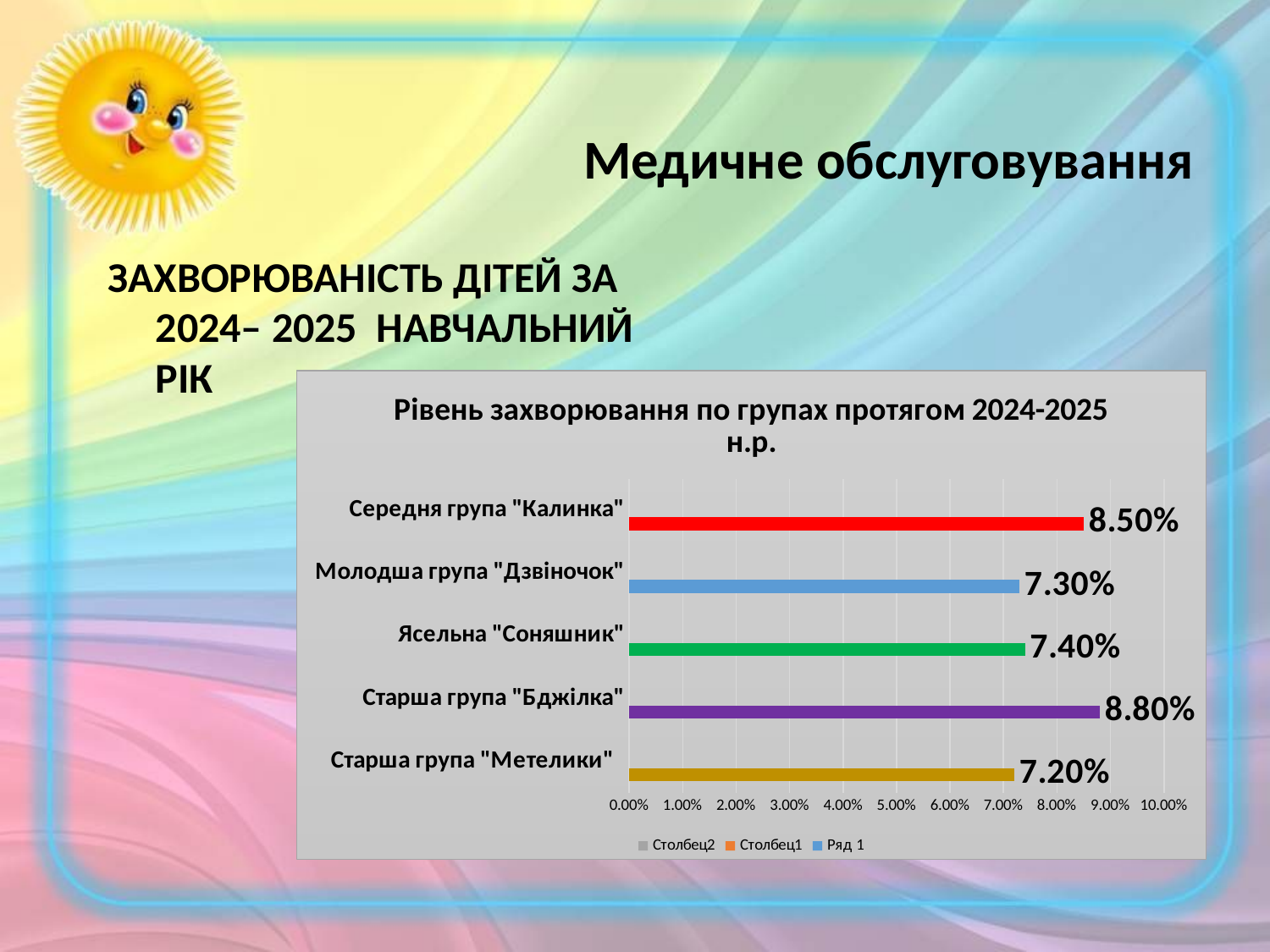
Which group has the highest value? Старша група "Бджілка" What is the difference between the values for Старша група "Бджілка" and Середня група "Калинка"? 0.30% What is the value for Ясельна "Соняшник"? 7.40% What kind of chart is shown on the slide? bar chart Which group has the lowest value? Старша група "Метелики" Is the value for Старша група "Бджілка" greater or less than 8.00%? greater How many groups are shown in the chart? 5 What is the value for Молодша група "Дзвіночок"? 7.30% Which is larger, the value for Середня група "Калинка" or the value for Ясельна "Соняшник"? Середня група "Калинка" What is the value for Старша група "Метелики"? 7.20% How many entries does the legend list? 3 What is the value for Середня група "Калинка"? 8.50%